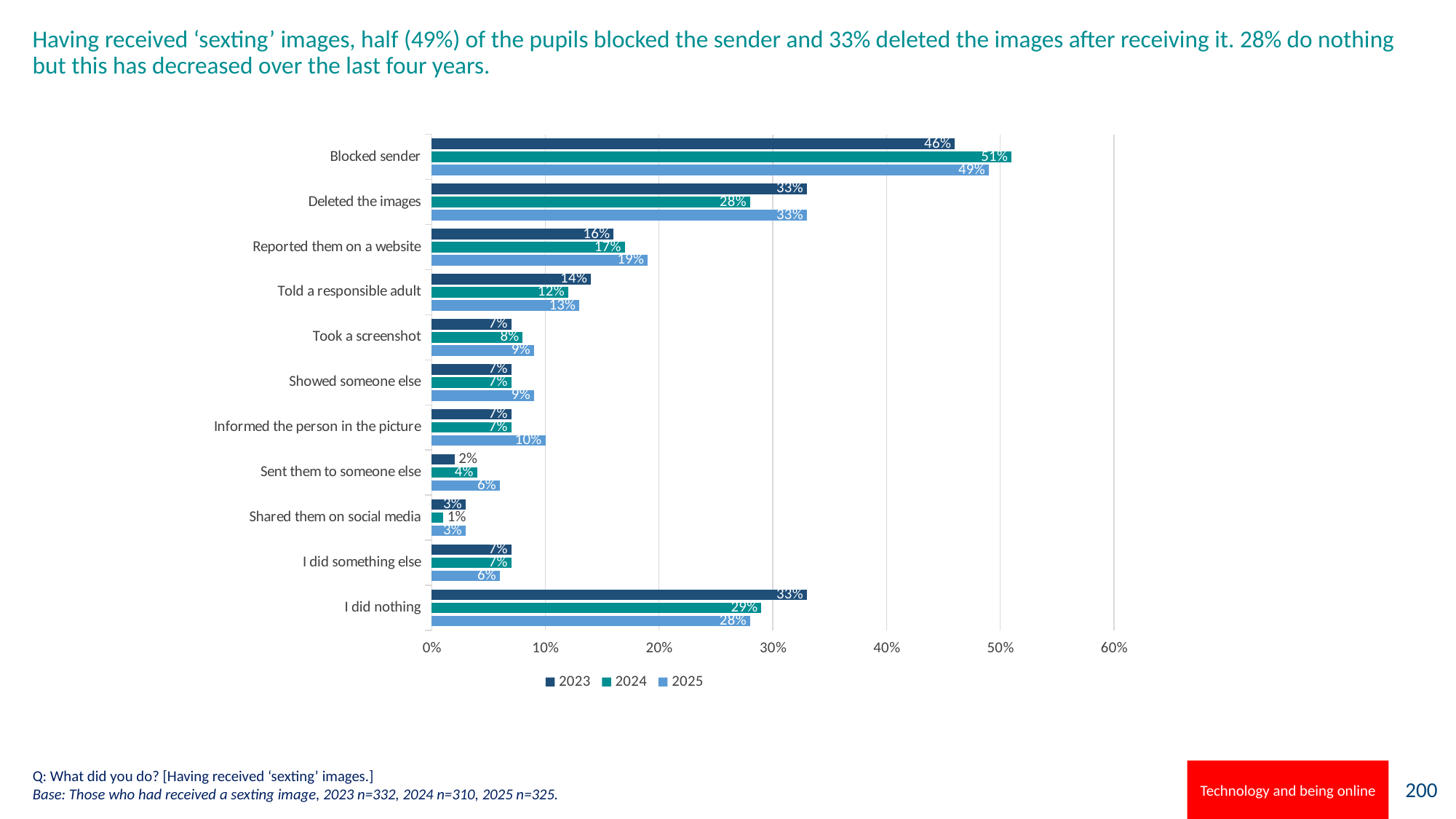
What percentage of pupils blocked the sender in 2025? 49% What percentage of pupils said 'I did nothing' in 2023? 33% How many categories are shown on the chart? 11 What is the value for 'Deleted the images' in 2024? 28% How many series does the legend list? 3 Which is larger for 'Reported them on a website': the 2023 value or the 2025 value? 2025 Which category has the lowest value in the 2024 series? Shared them on social media What is the difference between the 2024 and 2023 values for 'Blocked sender'? 5% What kind of chart is shown on the slide? Bar chart Did the value for 'I did nothing' rise or fall from 2023 to 2025? Fall Which category has the highest value in the 2024 series? Blocked sender Which year does the lightest blue bar represent according to the legend? 2025